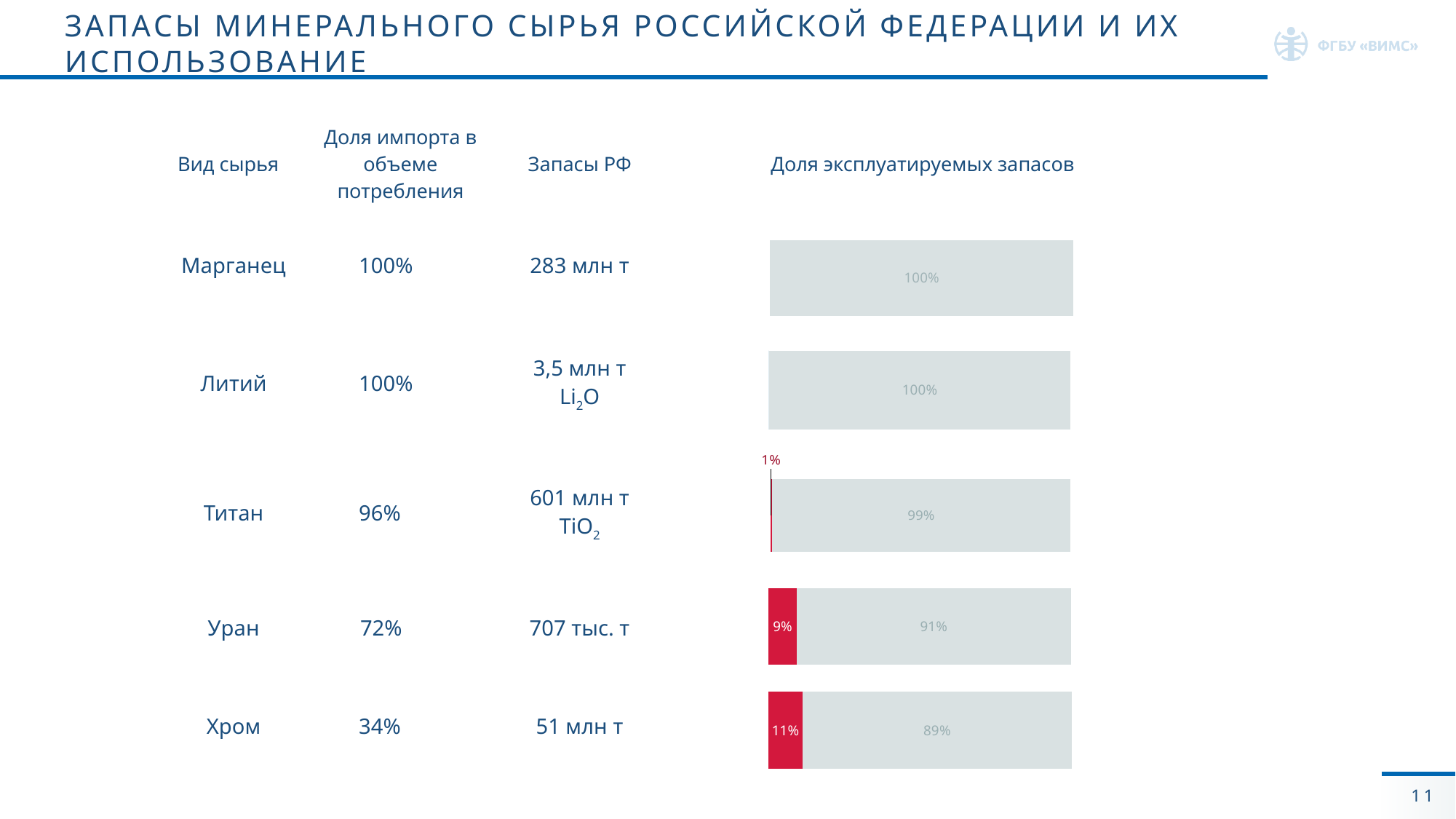
What is the red (exploited) share shown on the bar for Хром? 11% How many bars are shown in the "Доля эксплуатируемых запасов" column? 5 Which raw material has the largest red (exploited) share in the bars? Хром What is the red (exploited) share shown on the bar for Уран? 9% What is the grey share shown on the bar for Уран? 91% What is the difference between the red shares for Хром and Уран? 2% What is the red (exploited) share shown on the bar for Титан? 1% What kind of chart is used in the "Доля эксплуатируемых запасов" column? bar chart What is the total of the two segments on the bar for Хром? 100% What is the grey share shown on the bar for Марганец? 100% Which has a larger grey share on its bar, Титан or Хром? Титан What colour is the segment representing the exploited share on the bars? red